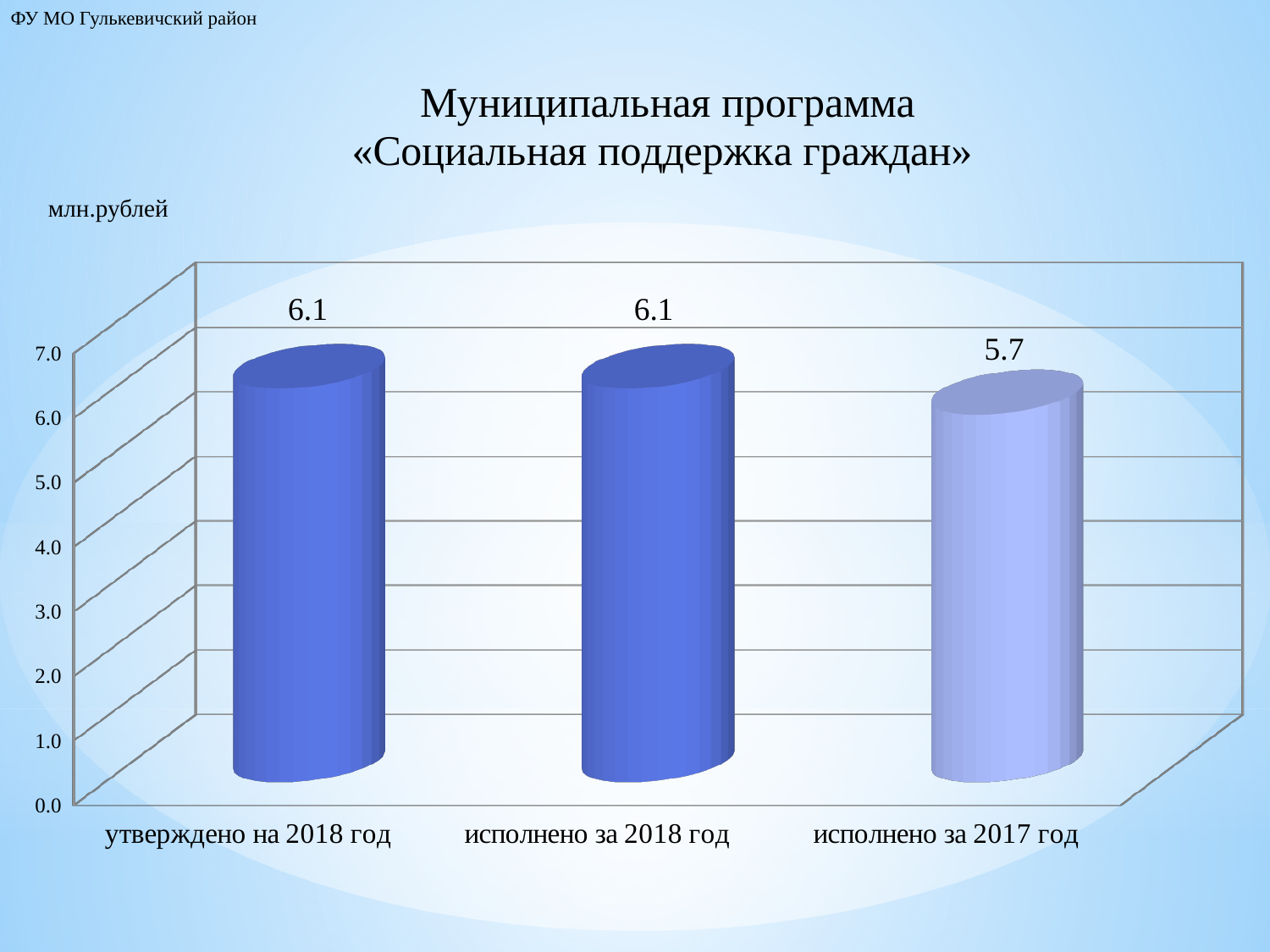
Which category has the lowest value? исполнено за 2017 год What is the value for «исполнено за 2018 год»? 6.1 What is the difference between the value for «исполнено за 2018 год» and the value for «исполнено за 2017 год»? 0.4 Is the value for «исполнено за 2018 год» greater or less than 5.0? greater Which is larger: the value for «утверждено на 2018 год» or the value for «исполнено за 2017 год»? утверждено на 2018 год What is the title of the chart? Муниципальная программа «Социальная поддержка граждан» What unit of measurement is indicated for the chart values? млн.рублей How many categories are shown on the chart? 3 What is the value for «утверждено на 2018 год»? 6.1 What is the value for «исполнено за 2017 год»? 5.7 What kind of chart is shown on the slide? bar chart Is the value for «исполнено за 2017 год» greater or less than 6.0? less